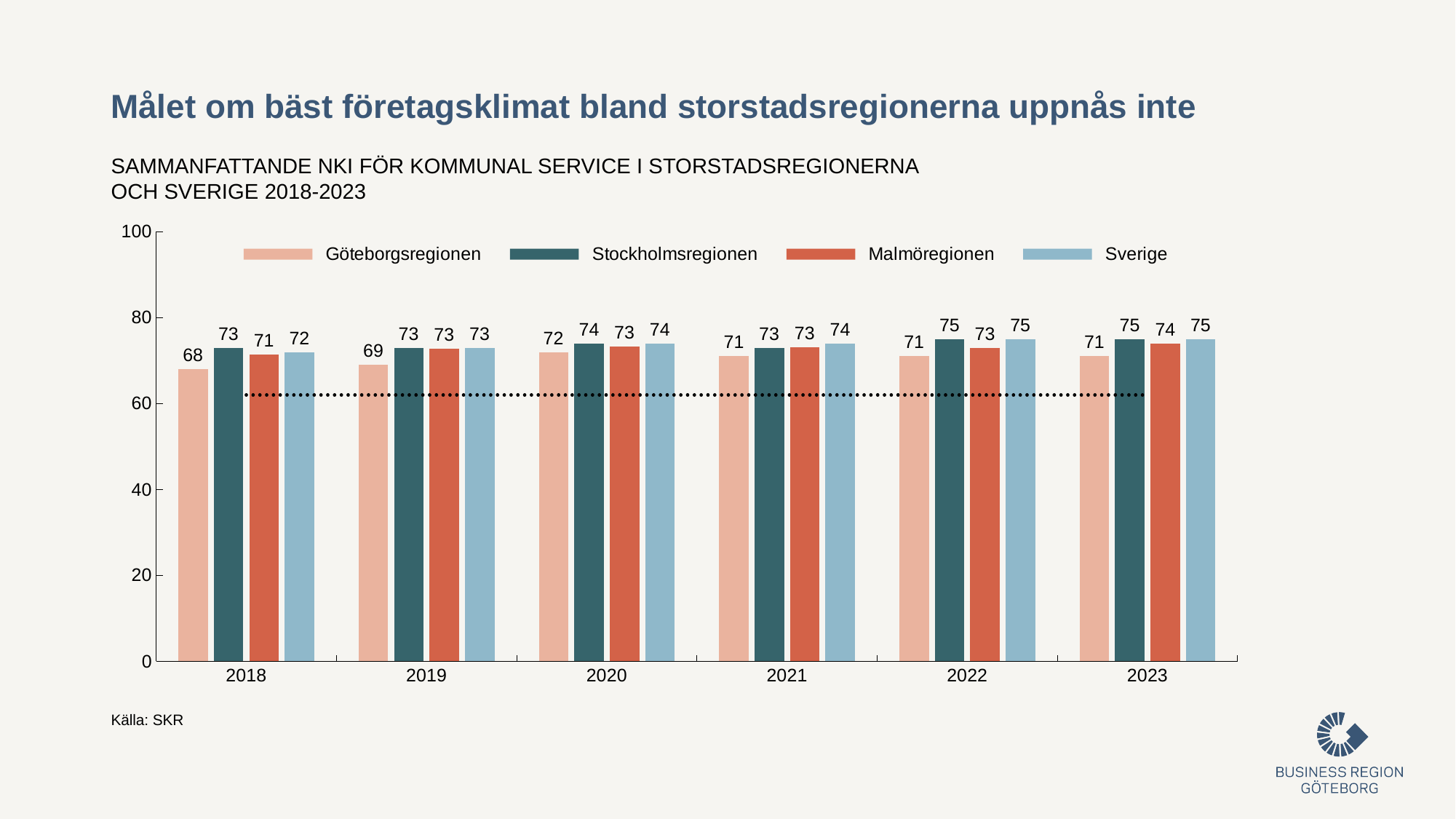
What is the value for Göteborgsregionen in 2018? 68 In which year is the value for Göteborgsregionen lowest? 2018 What is the source given below the chart? SKR What is the value for Stockholmsregionen in 2023? 75 What is the value for Malmöregionen in 2020? 73 How many series does the legend list? 4 How many years are shown on the x axis? 6 What is the value for Sverige in 2019? 73 What is the difference between Stockholmsregionen and Göteborgsregionen in 2023? 4 Is the value for Göteborgsregionen in 2021 greater or less than 60? greater Which is larger in 2018, Malmöregionen or Sverige? Sverige What kind of chart is shown on the slide? Bar chart